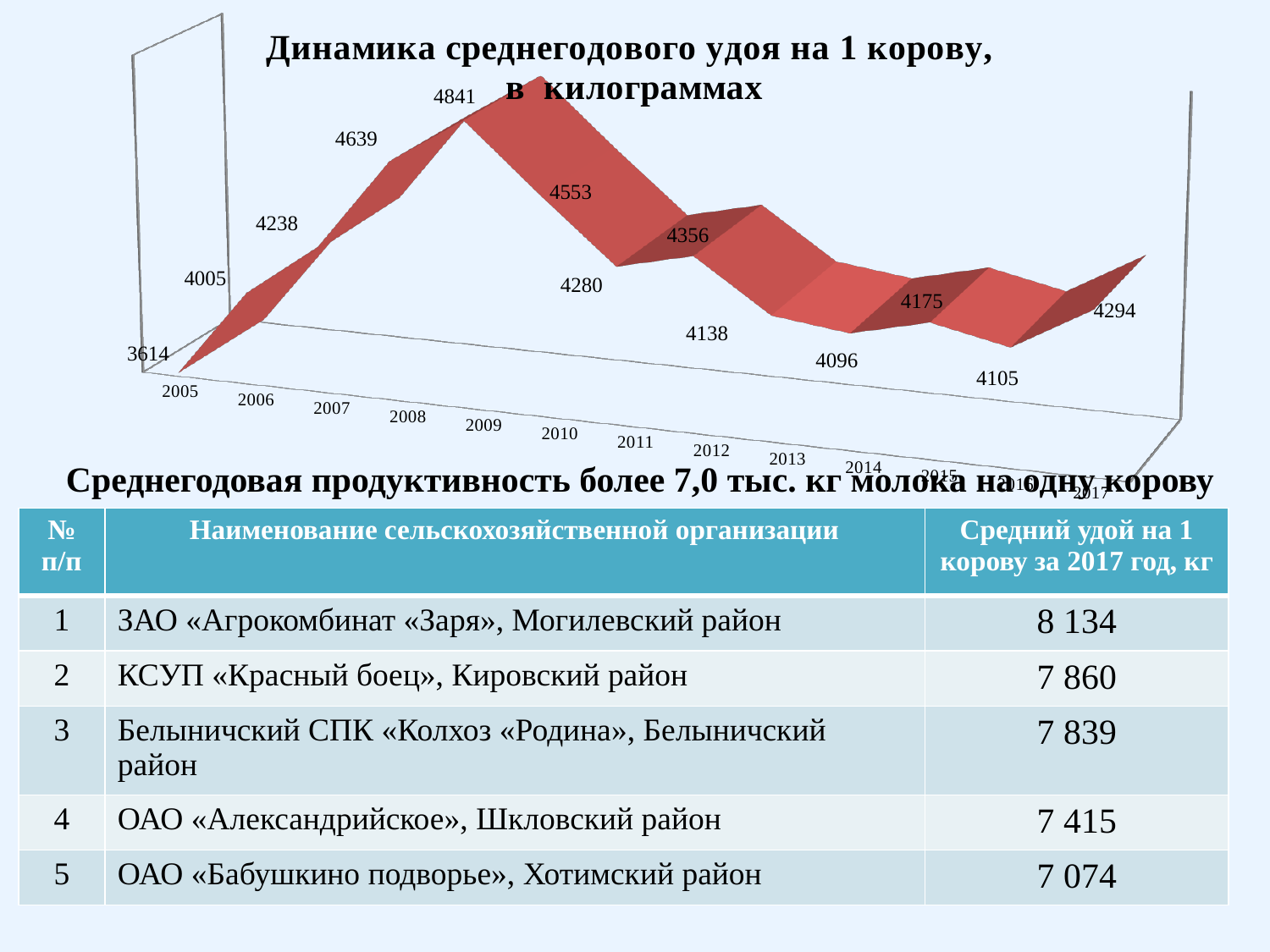
What is the average annual milk yield per cow shown for 2005? 3614 Which year has the highest average milk yield per cow on the chart? 2009 What value does the chart show for 2013? 4138 How many years are plotted on the chart? 13 What is the value plotted for 2017? 4294 What is the difference between the values for 2010 and 2011? 273 What type of chart is used to show the dynamics of milk yield per cow? Line chart By how much did the value change from 2005 to 2009? 1227 Which year has the larger value, 2012 or 2014? 2012 What value is shown for 2009 on the chart? 4841 Do the values rise or fall from 2005 to 2009? Rise Which year has the lowest value on the chart? 2005